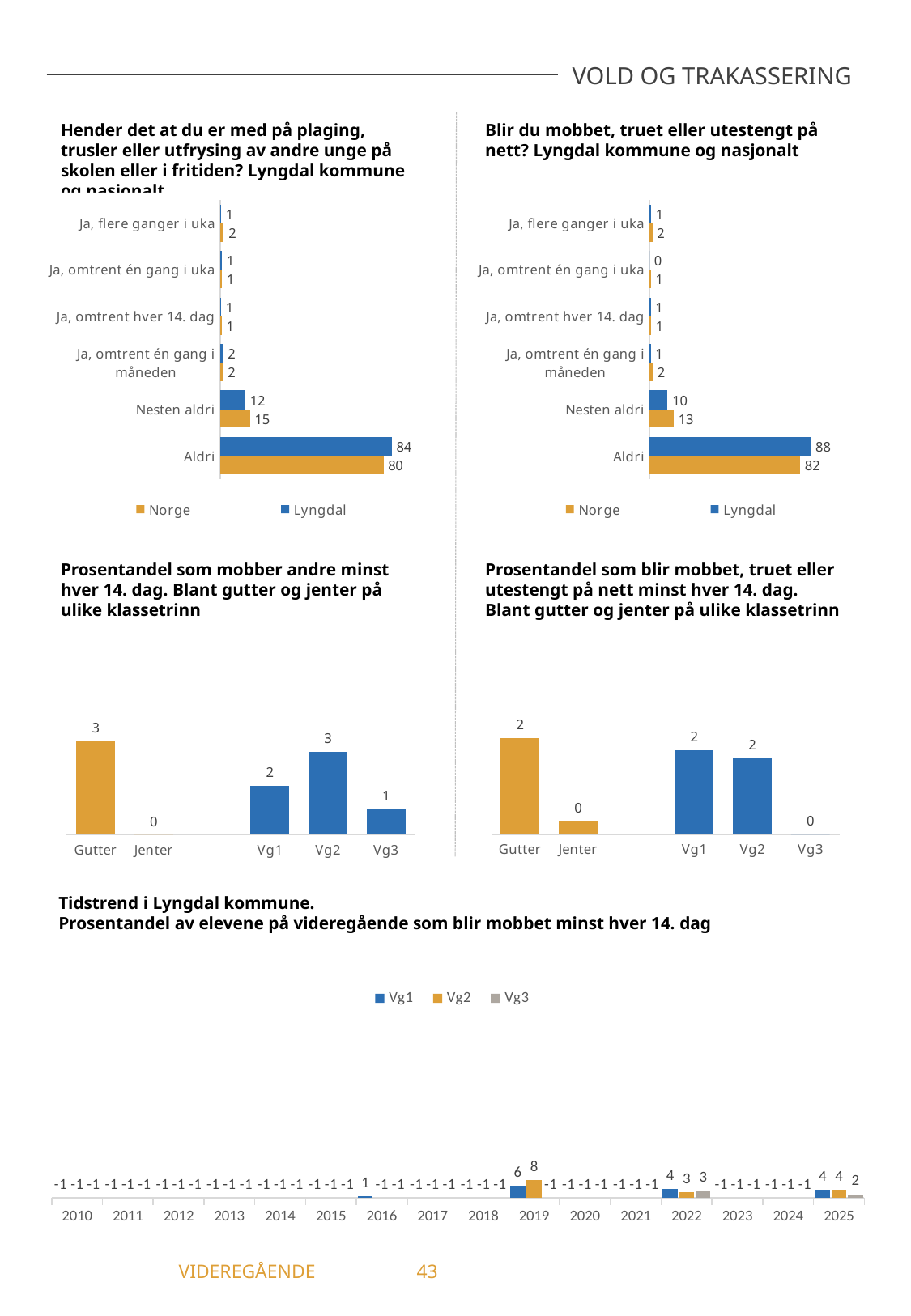
In the chart 'Prosentandel som mobber andre minst hver 14. dag', what is the value for Vg2? 3 In the chart 'Prosentandel som mobber andre minst hver 14. dag', which category has the lowest value? Jenter In the chart 'Hender det at du er med på plaging, trusler eller utfrysing av andre unge på skolen eller i fritiden?', what is the difference between the Lyngdal and Norge values for 'Aldri'? 4 In the chart 'Blir du mobbet, truet eller utestengt på nett? Lyngdal kommune og nasjonalt', how many series does the legend list? 2 In the chart 'Hender det at du er med på plaging, trusler eller utfrysing av andre unge på skolen eller i fritiden?', what is the value for Norge in the 'Nesten aldri' category? 15 In the chart 'Blir du mobbet, truet eller utestengt på nett? Lyngdal kommune og nasjonalt', what is the value for Lyngdal in the 'Aldri' category? 88 In the chart 'Blir du mobbet, truet eller utestengt på nett? Lyngdal kommune og nasjonalt', which is larger for 'Nesten aldri': Norge or Lyngdal? Norge In the chart 'Hender det at du er med på plaging, trusler eller utfrysing av andre unge på skolen eller i fritiden?', what is the value for Lyngdal in the 'Aldri' category? 84 In the chart 'Tidstrend i Lyngdal kommune', what kind of chart is it? Bar chart In the chart 'Blir du mobbet, truet eller utestengt på nett? Lyngdal kommune og nasjonalt', what is the value for Lyngdal in 'Ja, omtrent én gang i uka'? 0 In the chart 'Prosentandel som blir mobbet, truet eller utestengt på nett minst hver 14. dag', what is the value for Gutter? 2 In the chart 'Tidstrend i Lyngdal kommune', what is the value for Vg2 in 2019? 8